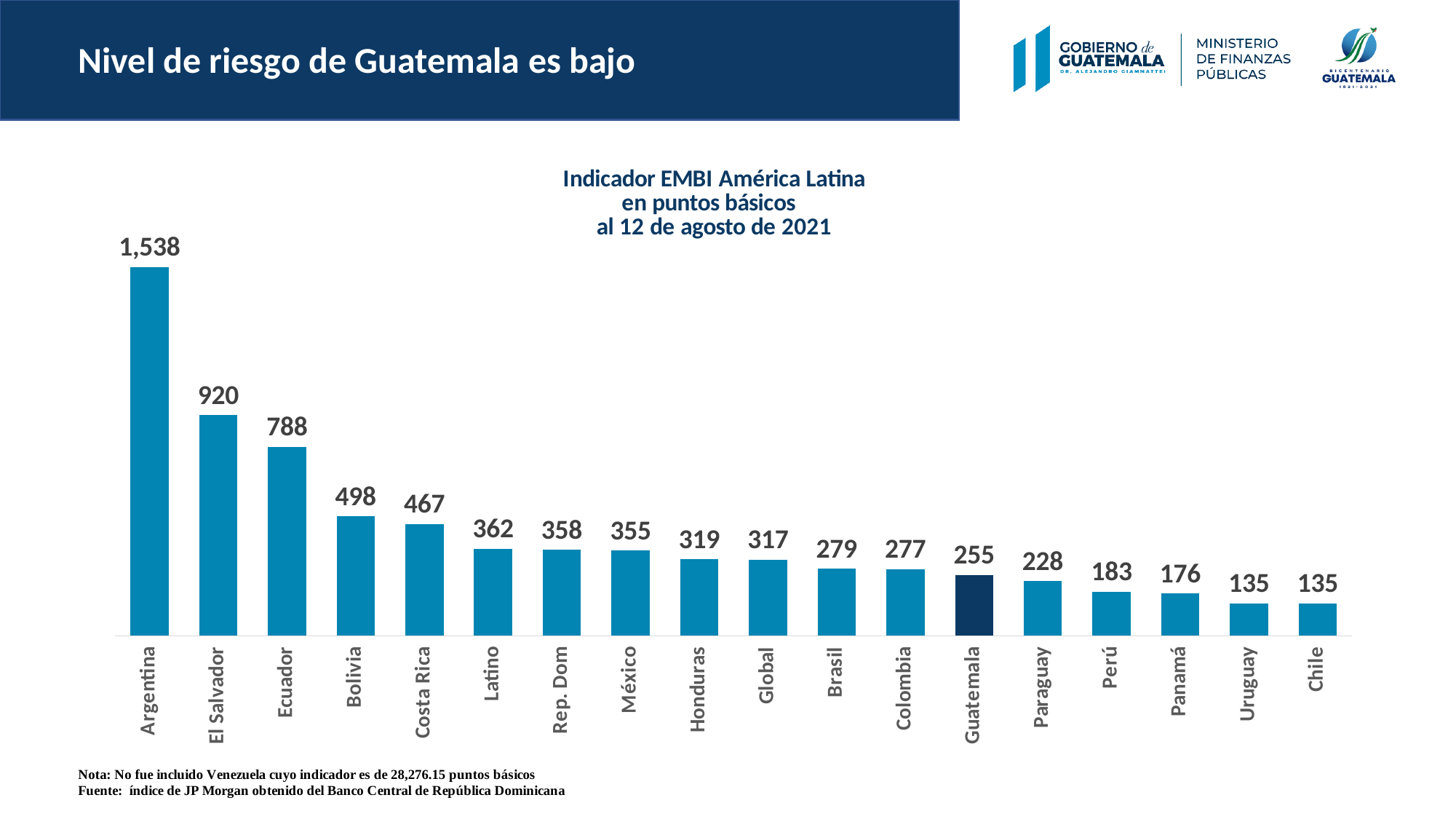
What is the EMBI value for Argentina? 1,538 What is the difference between the EMBI values of El Salvador and Ecuador? 132 What is the EMBI value for Guatemala? 255 Which has a higher EMBI value, Honduras or Brasil? Honduras Which has a higher EMBI value, Perú or Bolivia? Bolivia Which country has the highest EMBI value? Argentina What is the lowest EMBI value shown on the chart? 135 How many countries or categories are shown on the chart? 18 What kind of chart is shown on the slide? Bar chart What is the EMBI value for Costa Rica? 467 What is the difference between the EMBI values of Guatemala and Paraguay? 27 Which bar is shown in a darker colour than the others? Guatemala